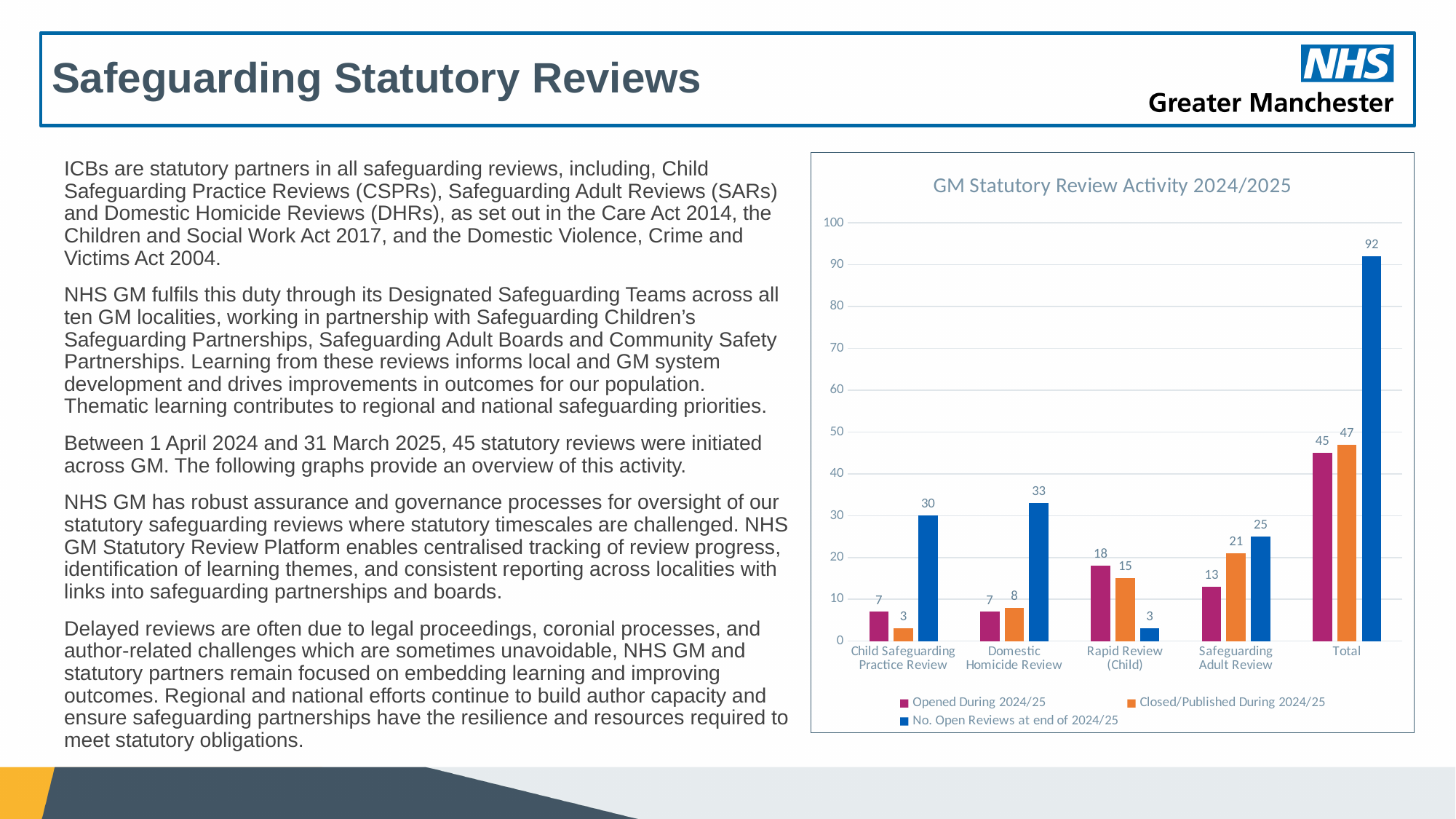
How many categories are shown on the x axis of the chart? 5 How many series does the chart legend list? 3 Which category has the highest value for No. Open Reviews at end of 2024/25? Total What is the value for Opened During 2024/25 for Rapid Review (Child)? 18 What is the difference between the Closed/Published During 2024/25 value and the Opened During 2024/25 value for Safeguarding Adult Review? 8 Excluding Total, which category has the lowest value for No. Open Reviews at end of 2024/25? Rapid Review (Child) What colour are the bars for No. Open Reviews at end of 2024/25? Blue What is the title of the chart? GM Statutory Review Activity 2024/2025 What is the value for Closed/Published During 2024/25 for Safeguarding Adult Review? 21 What type of chart is shown on the slide? Bar chart Which is larger for Child Safeguarding Practice Review: Opened During 2024/25 or Closed/Published During 2024/25? Opened During 2024/25 What is the value for No. Open Reviews at end of 2024/25 for Domestic Homicide Review? 33